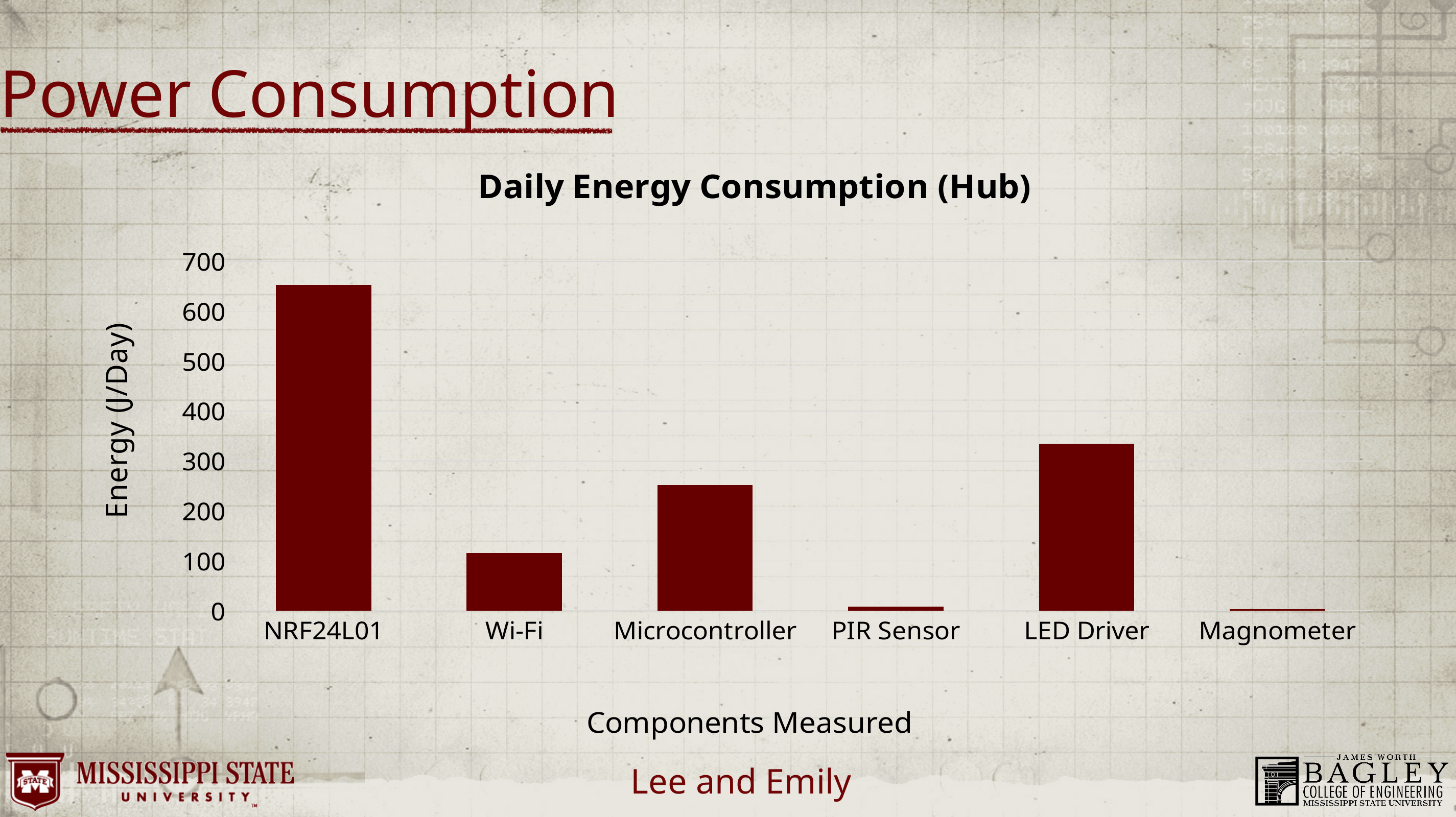
Which has a larger daily energy consumption, LED Driver or Microcontroller? LED Driver Is the value for PIR Sensor greater or less than 100? less Is the value for LED Driver greater or less than 300? greater Is the value for NRF24L01 greater or less than 600? greater Which has a larger daily energy consumption, Wi-Fi or Microcontroller? Microcontroller How many components are plotted on the x axis of the chart? 6 What is the title of the chart? Daily Energy Consumption (Hub) Which component has the highest daily energy consumption? NRF24L01 What kind of chart is shown on the slide? bar chart What is the label of the y axis? Energy (J/Day)